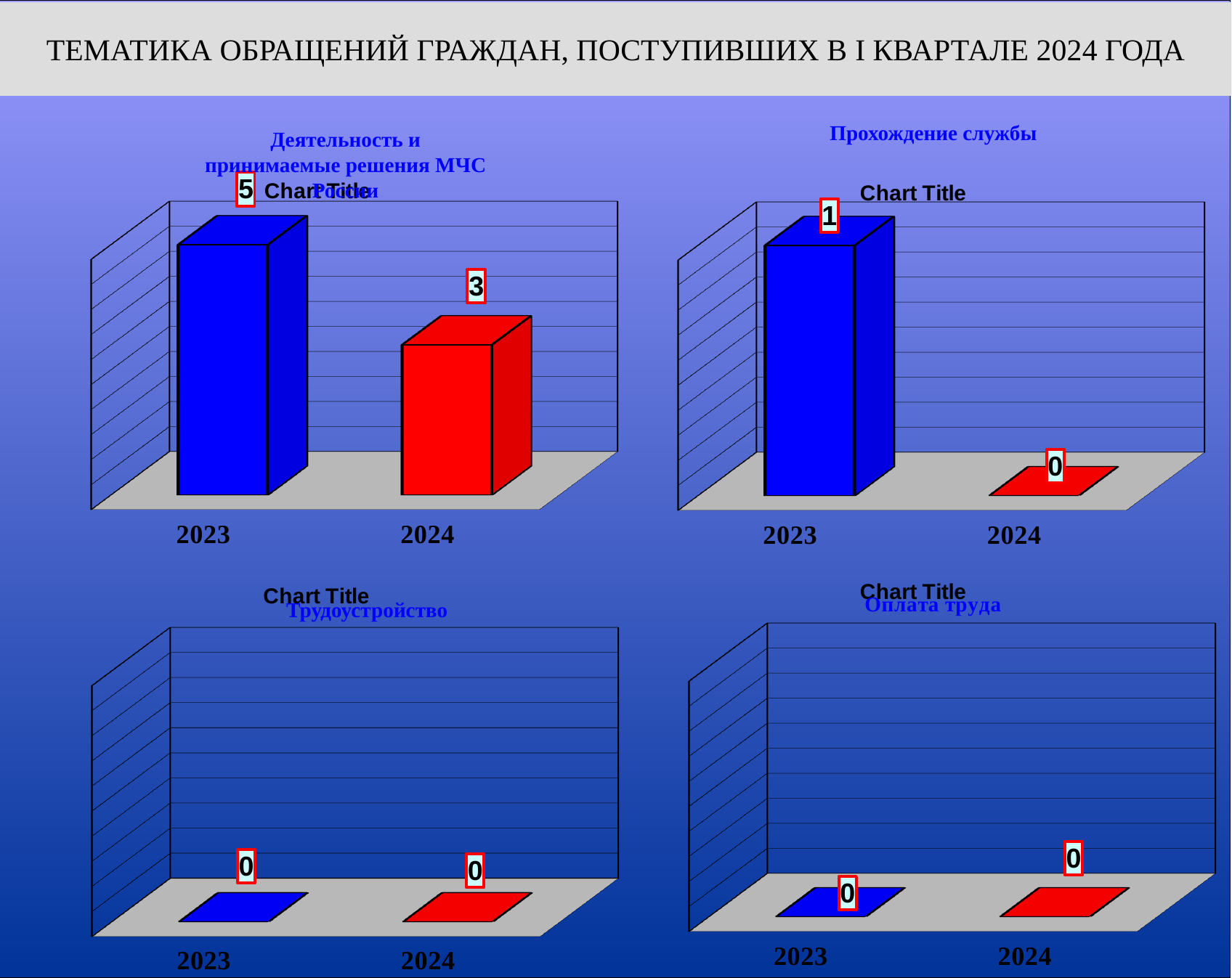
In the top-right chart (Прохождение службы), what is the value for 2024? 0 In the bottom-left chart (Трудоустройство), what is the value for 2024? 0 In the top-left chart (Деятельность и принимаемые решения МЧС России), what is the value for 2024? 3 In the top-left chart (Деятельность и принимаемые решения МЧС России), do the values rise or fall from 2023 to 2024? fall In the top-left chart (Деятельность и принимаемые решения МЧС России), what is the difference between the 2023 and 2024 values? 2 In the bottom-right chart (Оплата труда), what is the value for 2023? 0 In the top-left chart (Деятельность и принимаемые решения МЧС России), which year has the higher value? 2023 What kind of chart is the top-right chart (Прохождение службы)? bar chart In the top-right chart (Прохождение службы), which year has the lower value? 2024 In the top-left chart (Деятельность и принимаемые решения МЧС России), what is the value for 2023? 5 How many categories are shown on the x axis of the top-left chart (Деятельность и принимаемые решения МЧС России)? 2 In the top-right chart (Прохождение службы), what is the value for 2023? 1